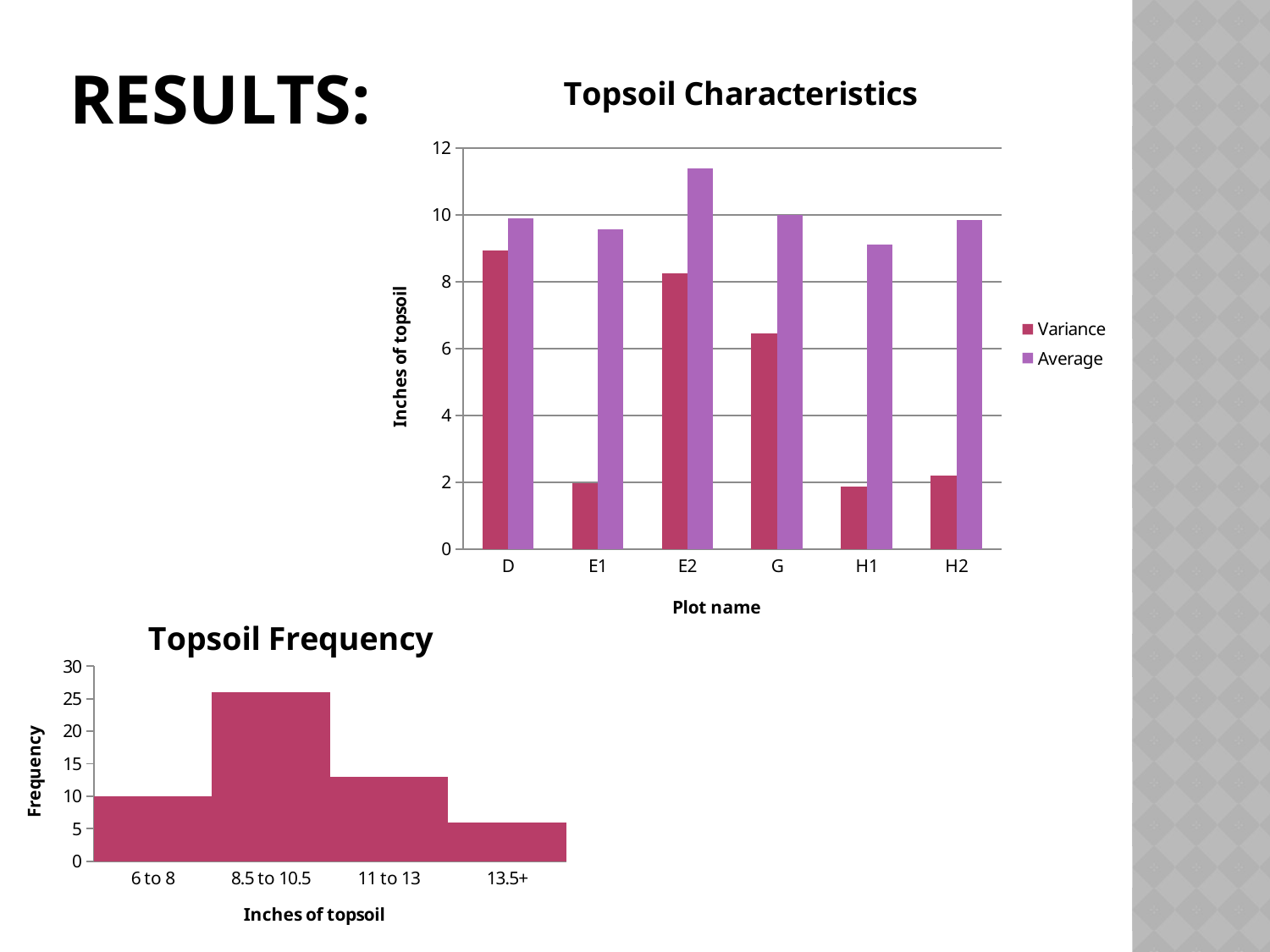
In the Topsoil Characteristics chart, is the Variance for G greater or less than 6? greater How many series does the legend of the Topsoil Characteristics chart list? 2 How many plot names are shown on the x axis of the Topsoil Characteristics chart? 6 What is the y-axis label of the Topsoil Characteristics chart? Inches of topsoil In the Topsoil Characteristics chart, which plot has the lowest Average? H1 In the Topsoil Frequency chart, which topsoil range has the highest frequency? 8.5 to 10.5 In the Topsoil Characteristics chart, is the Average for E2 greater or less than 10? greater In the Topsoil Characteristics chart, which plot has the highest Average? E2 In the Topsoil Characteristics chart, which plot has the highest Variance? D What kind of chart is the Topsoil Characteristics chart? bar chart How many topsoil ranges are shown on the x axis of the Topsoil Frequency chart? 4 In the Topsoil Characteristics chart, which is larger for plot D: the Variance or the Average? Average